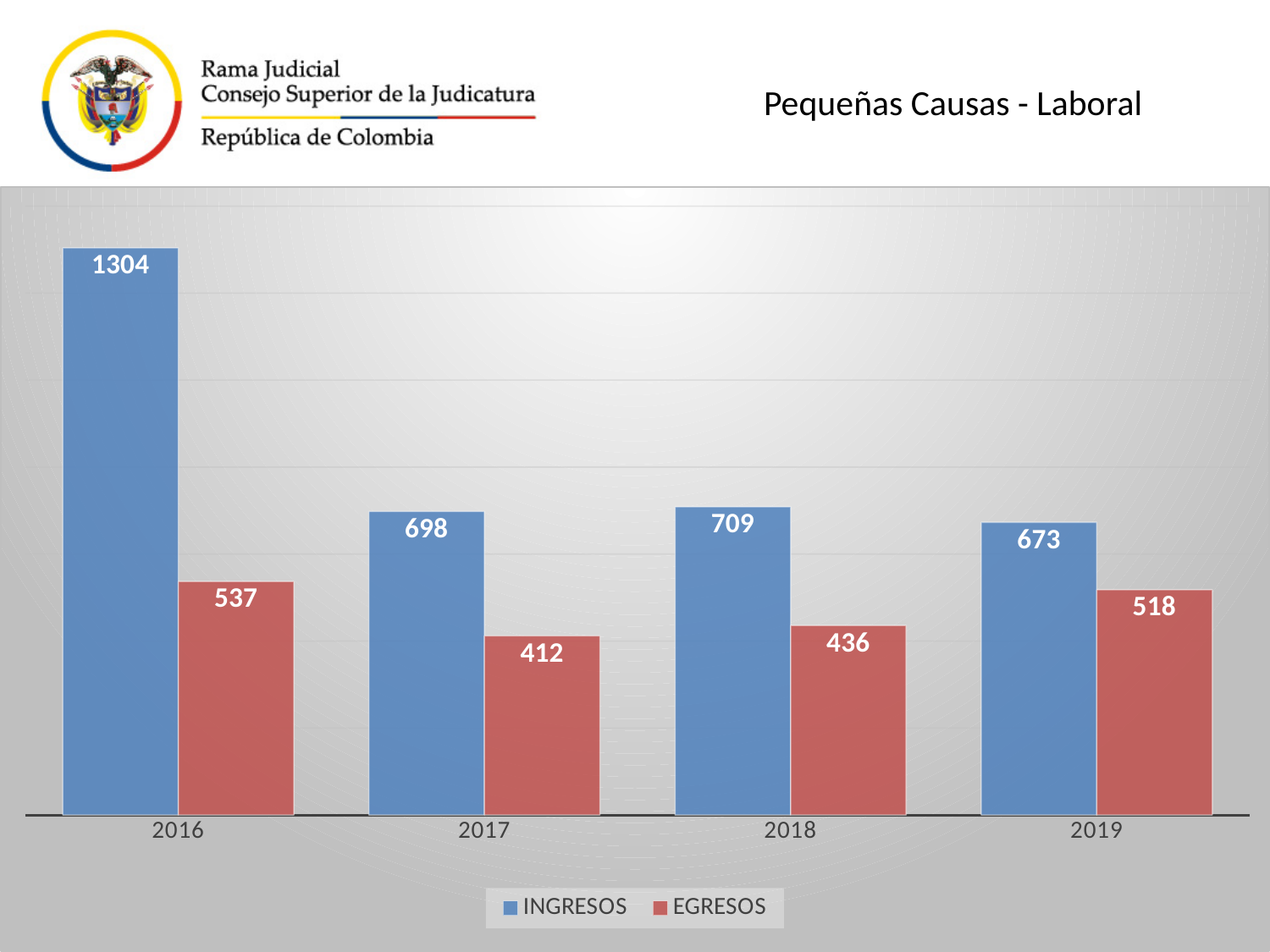
What is the INGRESOS value for 2016? 1304 Which is larger, INGRESOS in 2018 or INGRESOS in 2017? INGRESOS in 2018 What is the title of the chart? Pequeñas Causas - Laboral What is the difference between INGRESOS and EGRESOS in 2016? 767 How many years are shown on the x axis? 4 Which year has the lowest EGRESOS value? 2017 How many series does the legend list? 2 What is the EGRESOS value for 2018? 436 What is the INGRESOS value for 2019? 673 What kind of chart is shown on the slide? Bar chart Which year has the highest INGRESOS value? 2016 What is the EGRESOS value for 2017? 412